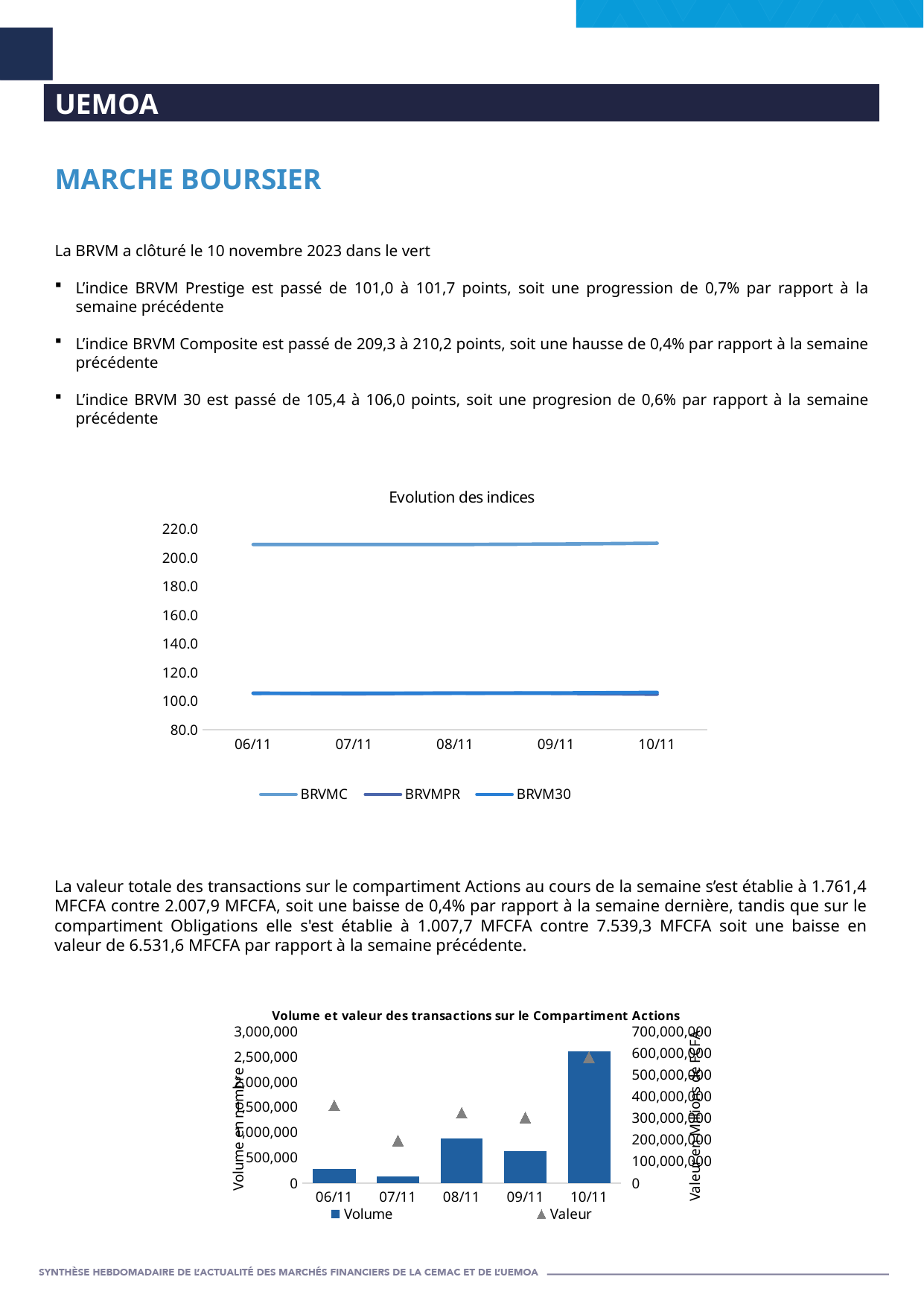
In "Volume et valeur des transactions sur le Compartiment Actions", which date has the lowest Valeur? 07/11 How many series does the legend of "Evolution des indices" list? 3 How many dates are shown on the x axis of "Evolution des indices"? 5 What type of chart is "Evolution des indices"? line chart In "Evolution des indices", which series has the highest values? BRVMC In "Volume et valeur des transactions sur le Compartiment Actions", which date has the highest Volume? 10/11 In "Volume et valeur des transactions sur le Compartiment Actions", is the Valeur on 10/11 greater or less than 500,000,000? greater In "Volume et valeur des transactions sur le Compartiment Actions", which is larger, the Volume on 08/11 or on 09/11? 08/11 In "Evolution des indices", is the value of BRVM30 on 06/11 greater or less than 120.0? less In "Volume et valeur des transactions sur le Compartiment Actions", is the Volume on 10/11 greater or less than 2,000,000? greater In "Volume et valeur des transactions sur le Compartiment Actions", which date has the lowest Volume? 07/11